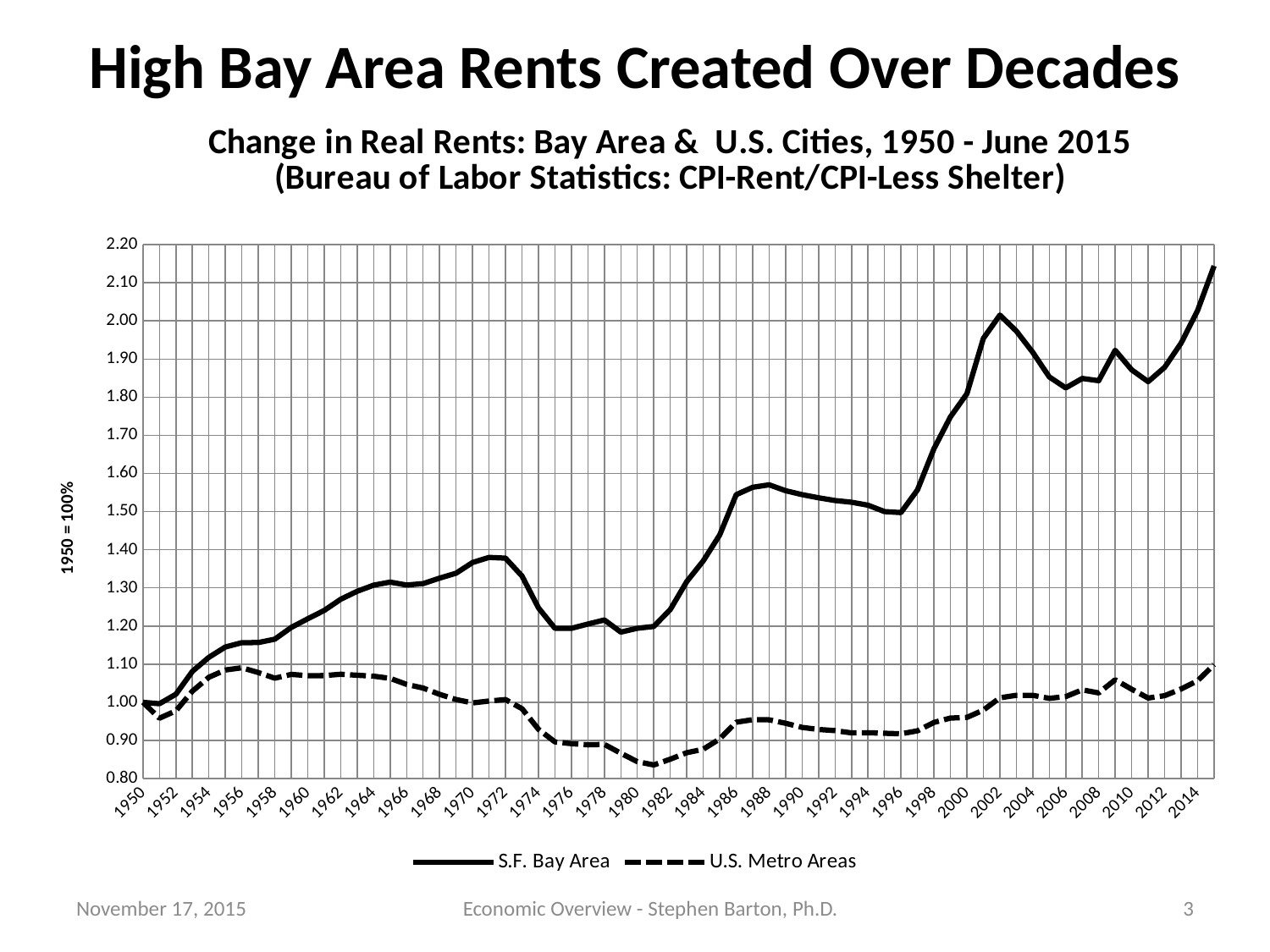
Is the value for U.S. Metro Areas in 1981 greater or less than 0.90? less Does the U.S. Metro Areas line rise or fall between 1956 and 1981? fall What are the two series named in the legend? S.F. Bay Area and U.S. Metro Areas In 1990, which series has the higher value, S.F. Bay Area or U.S. Metro Areas? S.F. Bay Area Is the value for S.F. Bay Area in 1972 greater or less than 1.30? greater Is the value for U.S. Metro Areas in 1956 greater or less than 1.00? greater Does the S.F. Bay Area line rise or fall between 1996 and 2002? rise What kind of chart is shown on the slide? line chart How many series does the legend list? 2 What is the label on the vertical axis of the chart? 1950 = 100%